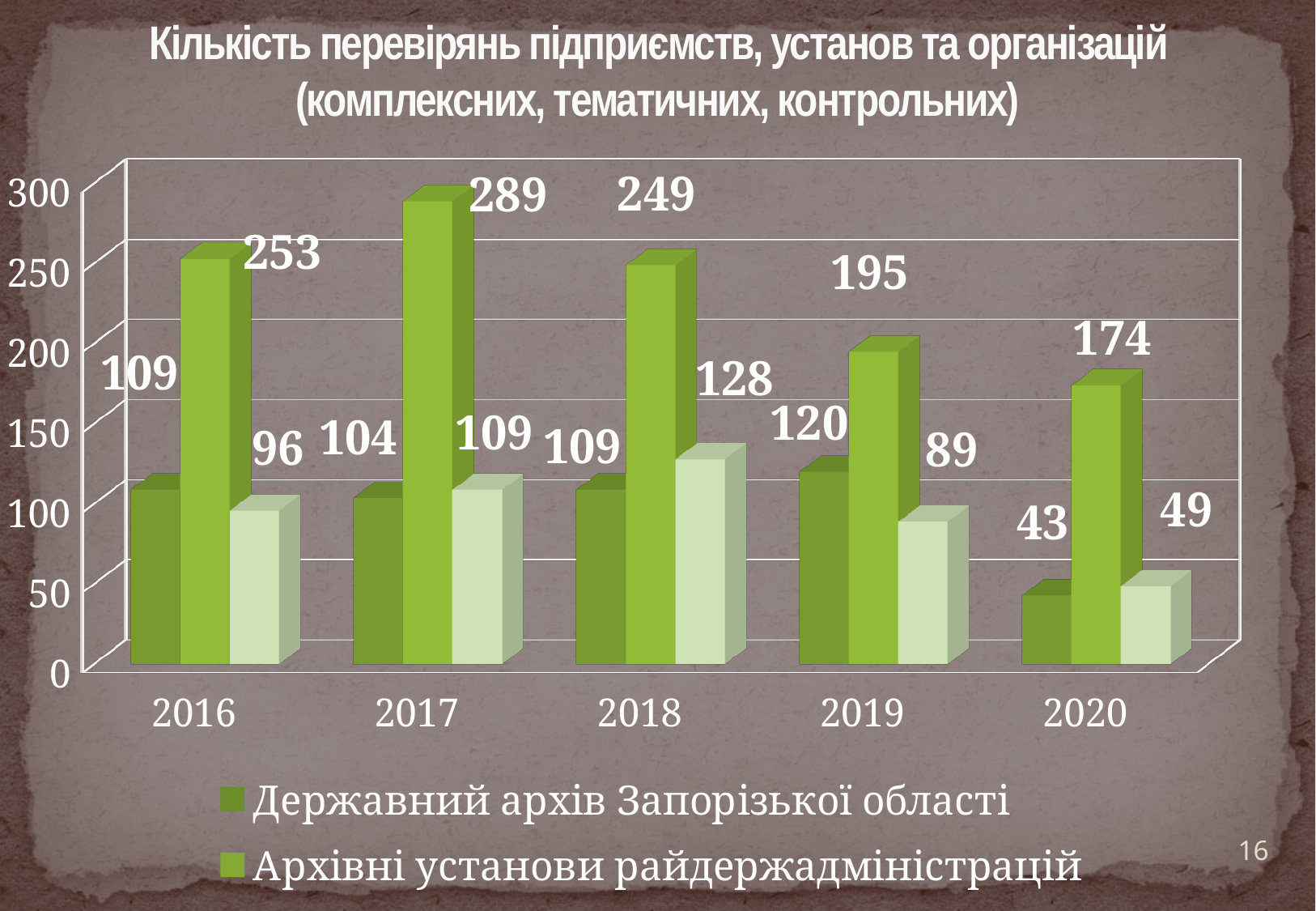
In which year is the value for Державний архів Запорізької області the lowest? 2020 Which is larger: Державний архів Запорізької області in 2016 or Архівні установи райдержадміністрацій in 2020? Архівні установи райдержадміністрацій in 2020 How many series does the legend list? 2 What kind of chart is shown on the slide? bar chart What is the value for Державний архів Запорізької області in 2020? 43 How many years are shown on the x axis? 5 What is the value for Архівні установи райдержадміністрацій in 2017? 289 In which year is the value for Архівні установи райдержадміністрацій the highest? 2017 What is the value for Державний архів Запорізької області in 2019? 120 By how much did the value for Державний архів Запорізької області fall from 2019 to 2020? 77 In 2018, what is the difference between Архівні установи райдержадміністрацій and Державний архів Запорізької області? 140 Does the value for Архівні установи райдержадміністрацій rise or fall from 2017 to 2020? fall